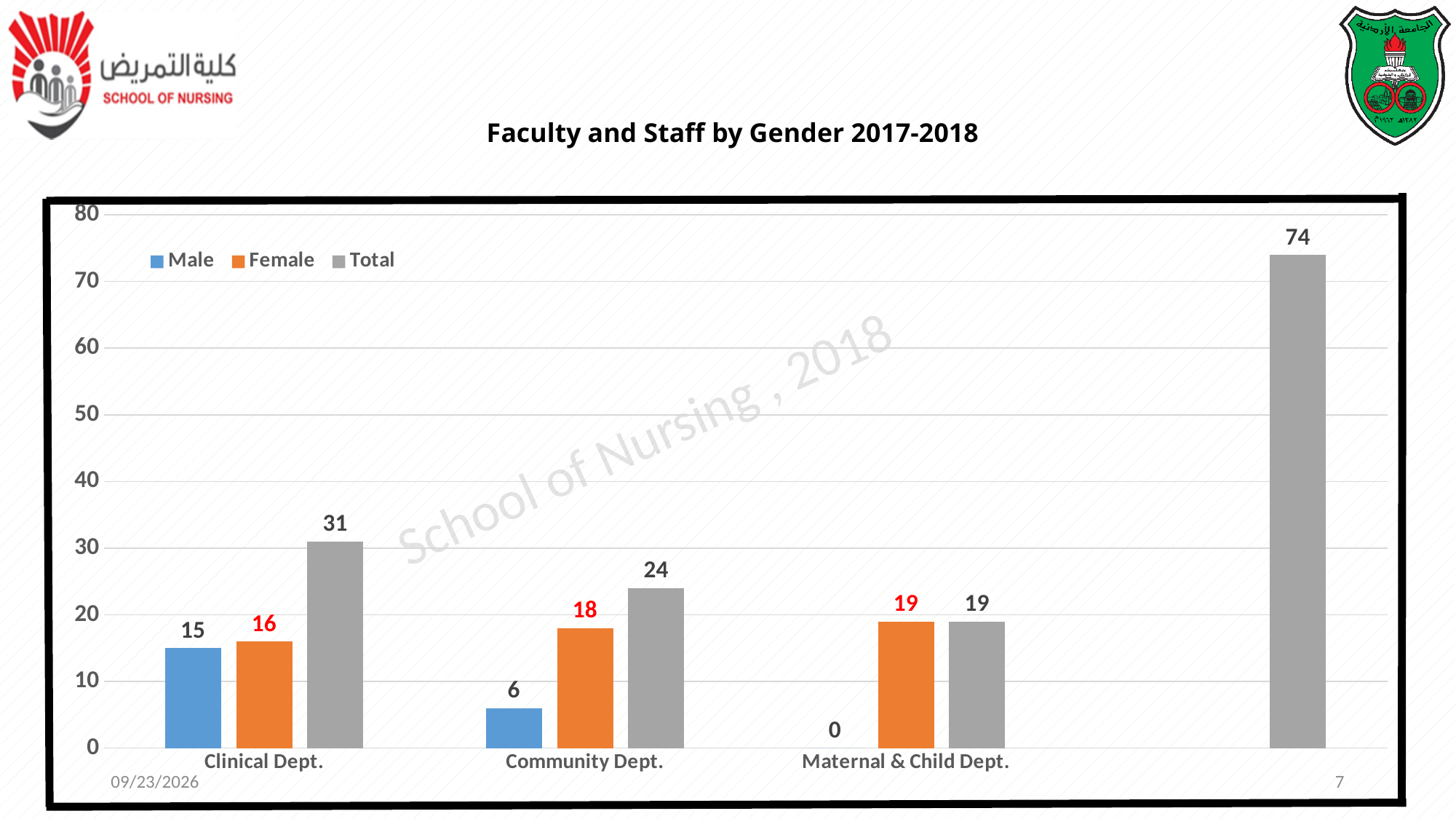
What is the difference between the Female and Male values for Community Dept.? 12 Among the labelled departments, which has the highest Male value? Clinical Dept. What is the Total value for Maternal & Child Dept.? 19 Which is larger, the Male value for Clinical Dept. or the Male value for Community Dept.? Clinical Dept. What is the Female value for Community Dept.? 18 How many series does the legend list? 3 What kind of chart is shown on the slide? Bar chart What is the difference between the Female and Male values for Clinical Dept.? 1 Among the labelled departments, which has the lowest Female value? Clinical Dept. What is the Male value for Clinical Dept.? 15 What is the Total value for Clinical Dept.? 31 What is the Male value for Maternal & Child Dept.? 0